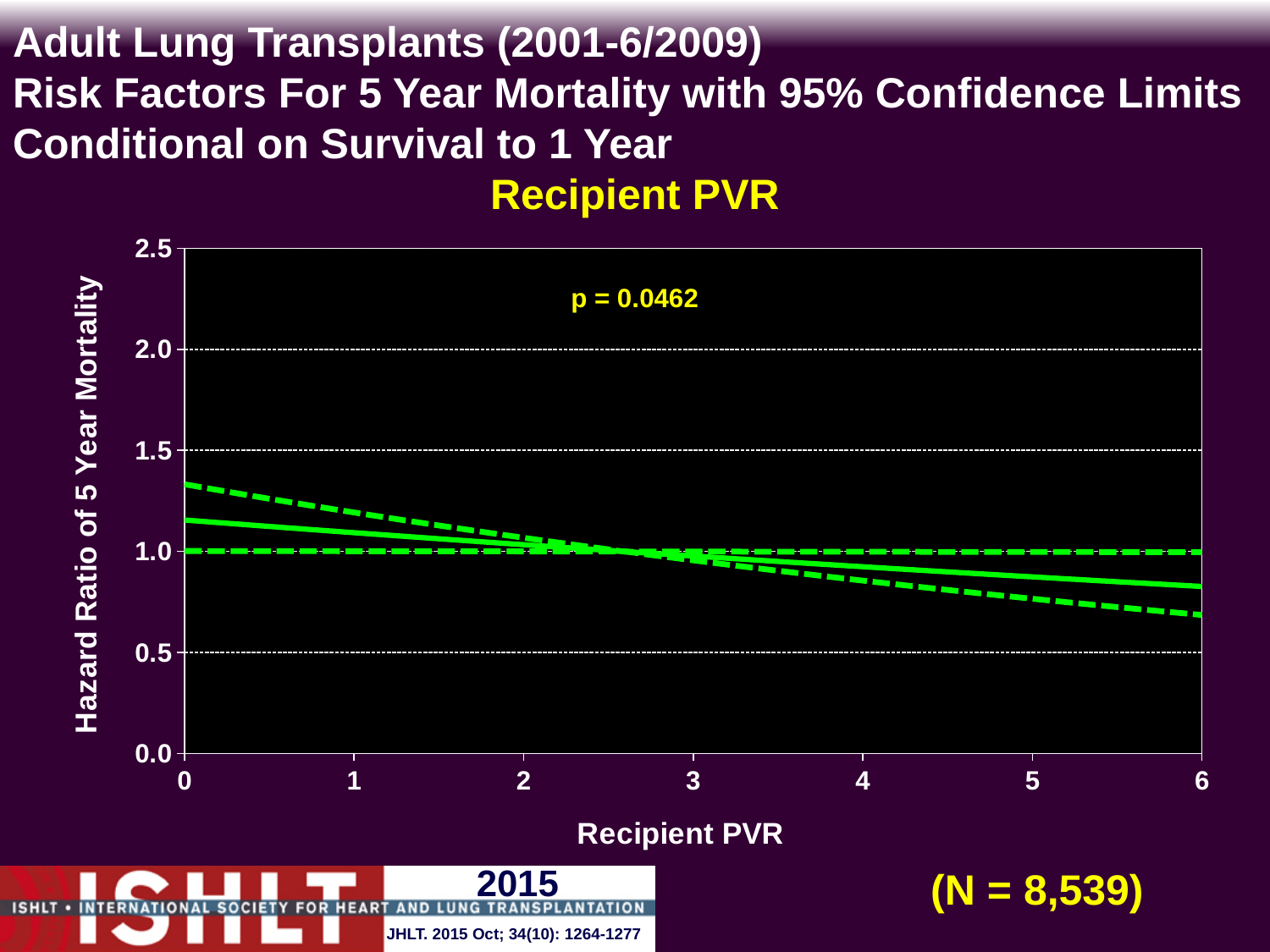
Does the solid hazard ratio line rise or fall as Recipient PVR increases from 0 to 6? fall What p-value is printed on the chart? p = 0.0462 Is the hazard ratio (solid line) at Recipient PVR 0 greater or less than 1.0? greater What kind of chart is shown on the slide? line chart Is the lower confidence limit (lower dashed line) at Recipient PVR 6 greater or less than 0.5? greater What is the title of the chart? Recipient PVR What is the maximum value shown on the y axis? 2.5 Is the upper confidence limit (upper dashed line) at Recipient PVR 0 greater or less than 1.5? less What is the label of the y axis? Hazard Ratio of 5 Year Mortality What is the sample size (N) shown on the slide? 8,539